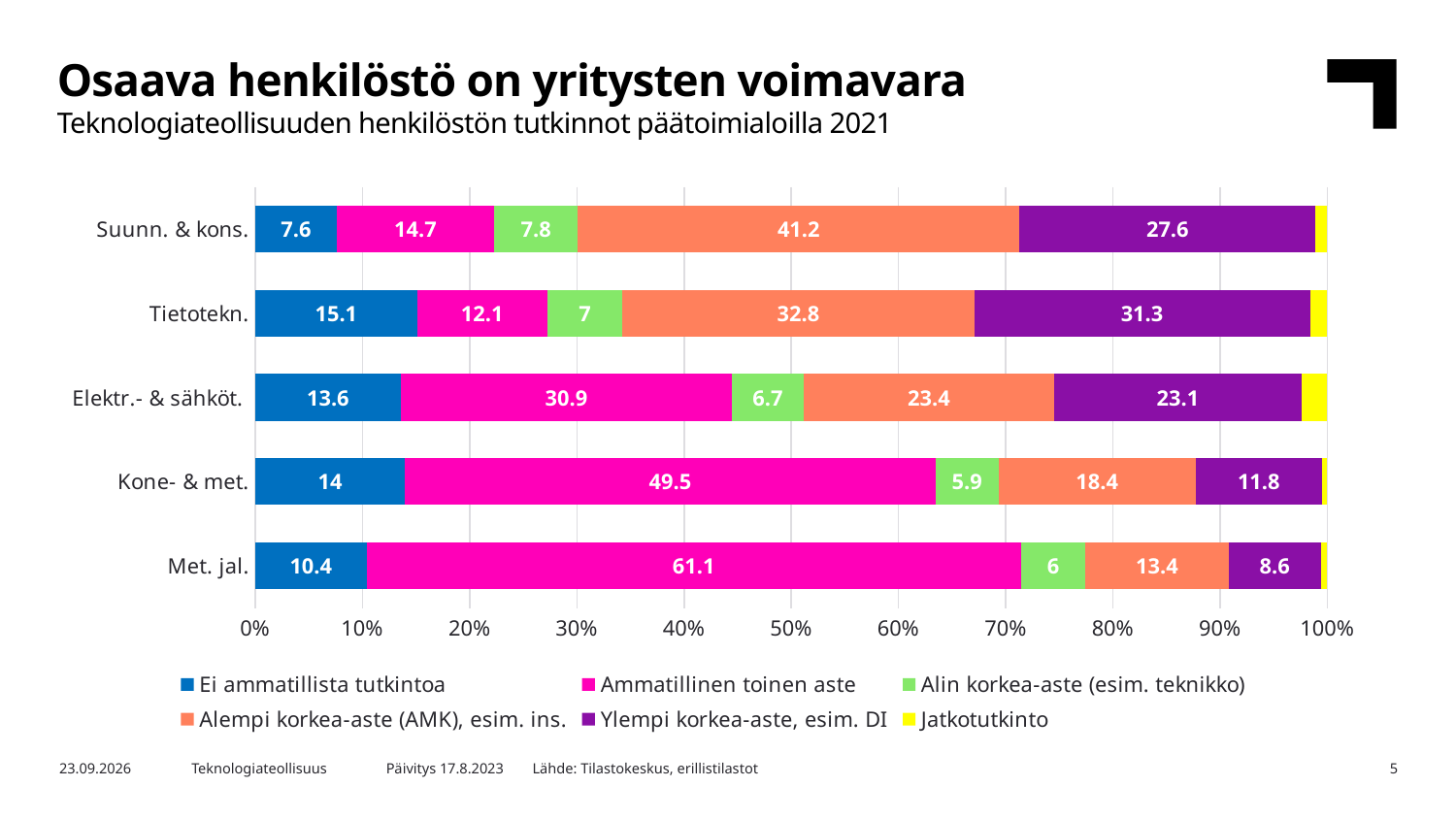
How many categories (bars) are shown in the chart? 5 What kind of chart is shown on the slide? Stacked bar chart Which category has the highest value for Ylempi korkea-aste, esim. DI? Tietotekn. Which category has the lowest value for Ei ammatillista tutkintoa? Suunn. & kons. What is the value for Ei ammatillista tutkintoa in the Kone- & met. bar? 14 How many series does the legend list? 6 What is the difference between the Alempi korkea-aste (AMK), esim. ins. values for Suunn. & kons. and Tietotekn.? 8.4 What is the value for Ylempi korkea-aste, esim. DI in the Tietotekn. bar? 31.3 What is the value for Alempi korkea-aste (AMK), esim. ins. in the Suunn. & kons. bar? 41.2 Which category has the highest value for Ammatillinen toinen aste? Met. jal. What is the value for Ammatillinen toinen aste in the Met. jal. bar? 61.1 Which has a larger value for Alempi korkea-aste (AMK), esim. ins.: Kone- & met. or Met. jal.? Kone- & met.